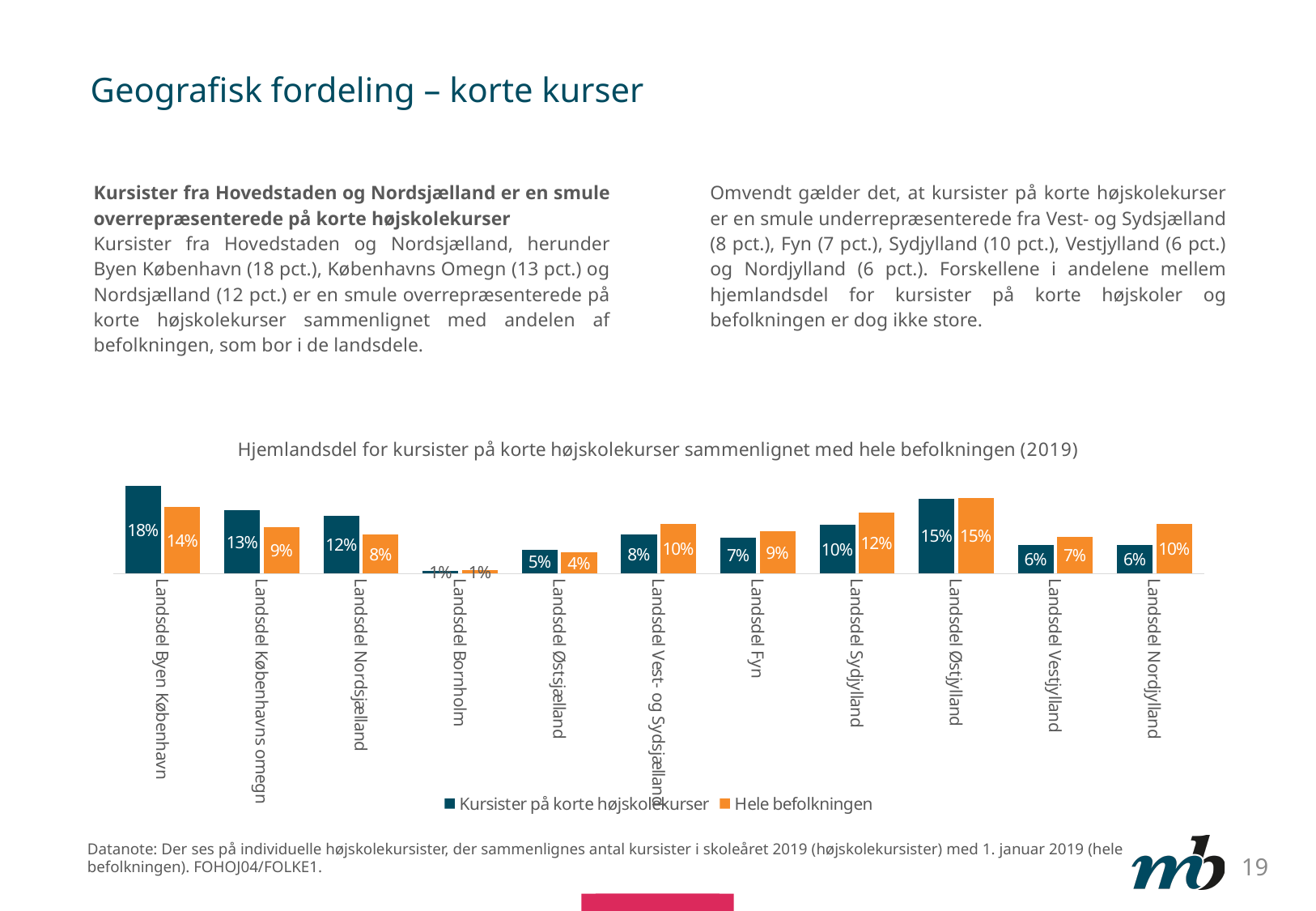
What kind of chart is shown on the slide? Bar chart What is the value for Hele befolkningen in Landsdel Nordjylland? 10% How many series does the legend list? 2 Which landsdel has the highest value for Kursister på korte højskolekurser? Landsdel Byen København Which is larger in Landsdel Fyn: Kursister på korte højskolekurser or Hele befolkningen? Hele befolkningen What is the value for Kursister på korte højskolekurser in Landsdel Byen København? 18% How many landsdele (categories) are shown on the x axis? 11 What is the difference between Hele befolkningen and Kursister på korte højskolekurser in Landsdel Nordjylland? 4% What is the title of the chart? Hjemlandsdel for kursister på korte højskolekurser sammenlignet med hele befolkningen (2019) What is the value for Hele befolkningen in Landsdel Sydjylland? 12% Which landsdel has the lowest value for Hele befolkningen? Landsdel Bornholm What is the difference between Kursister på korte højskolekurser and Hele befolkningen in Landsdel Byen København? 4%